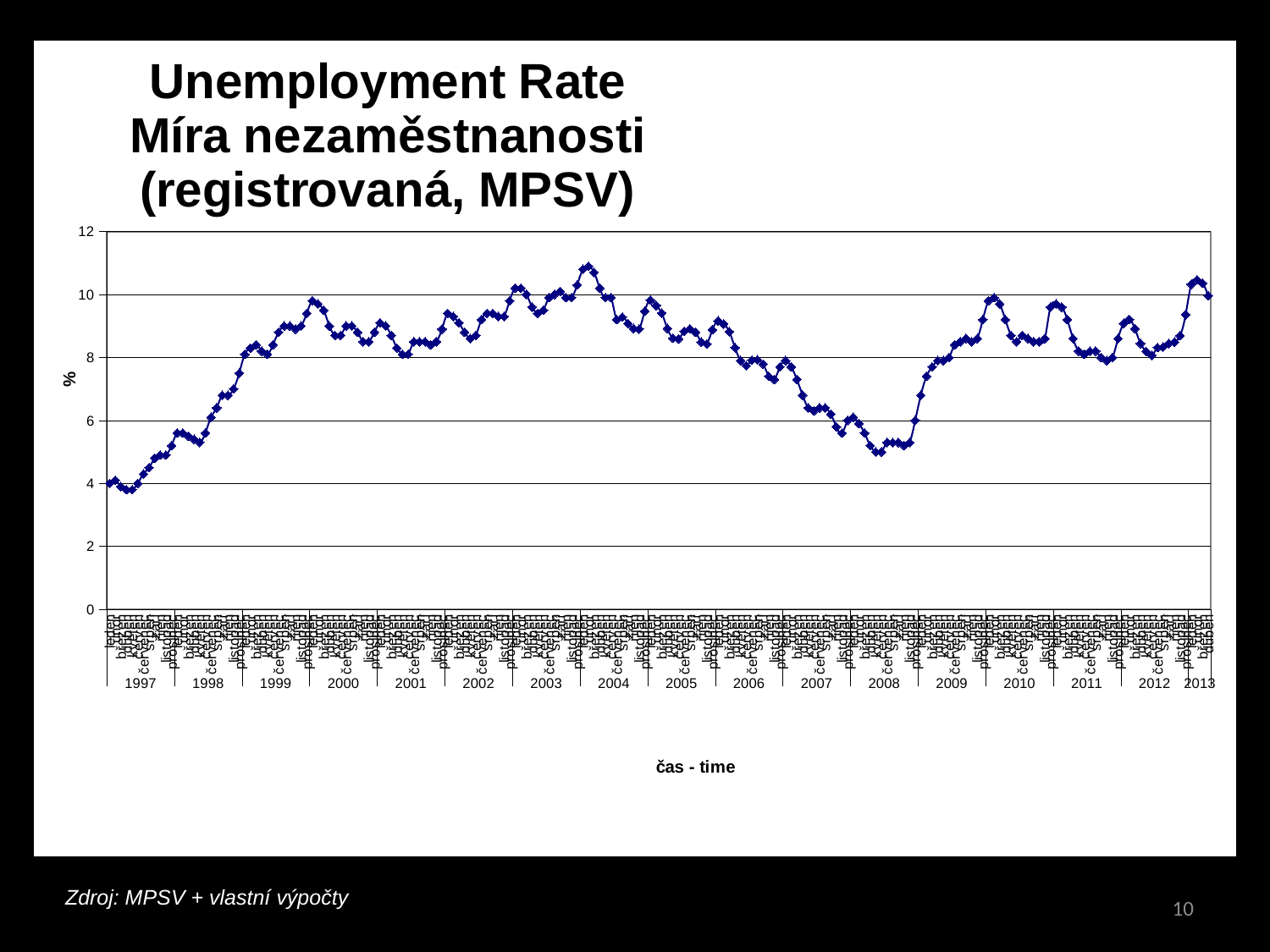
Does the unemployment rate rise or fall between 2004 and 2008? fall Does the unemployment rate rise or fall between 1997 and 1999? rise What is the label on the vertical axis of the chart? % Which is higher, the unemployment rate at the start of 1997 or at the start of 2013? 2013 What is the title of the horizontal axis of the chart? čas - time In which year does the unemployment rate reach its highest point on the chart? 2004 Is the peak unemployment rate in 2004 greater or less than 10? greater What kind of chart is shown on the slide? line chart In which year does the unemployment rate reach its lowest point on the chart? 1997 Is the unemployment rate at the start of 1997 greater or less than 6? less Is the unemployment rate at its low point in 2008 greater or less than 6? less How many years are labelled along the x axis of the chart? 17